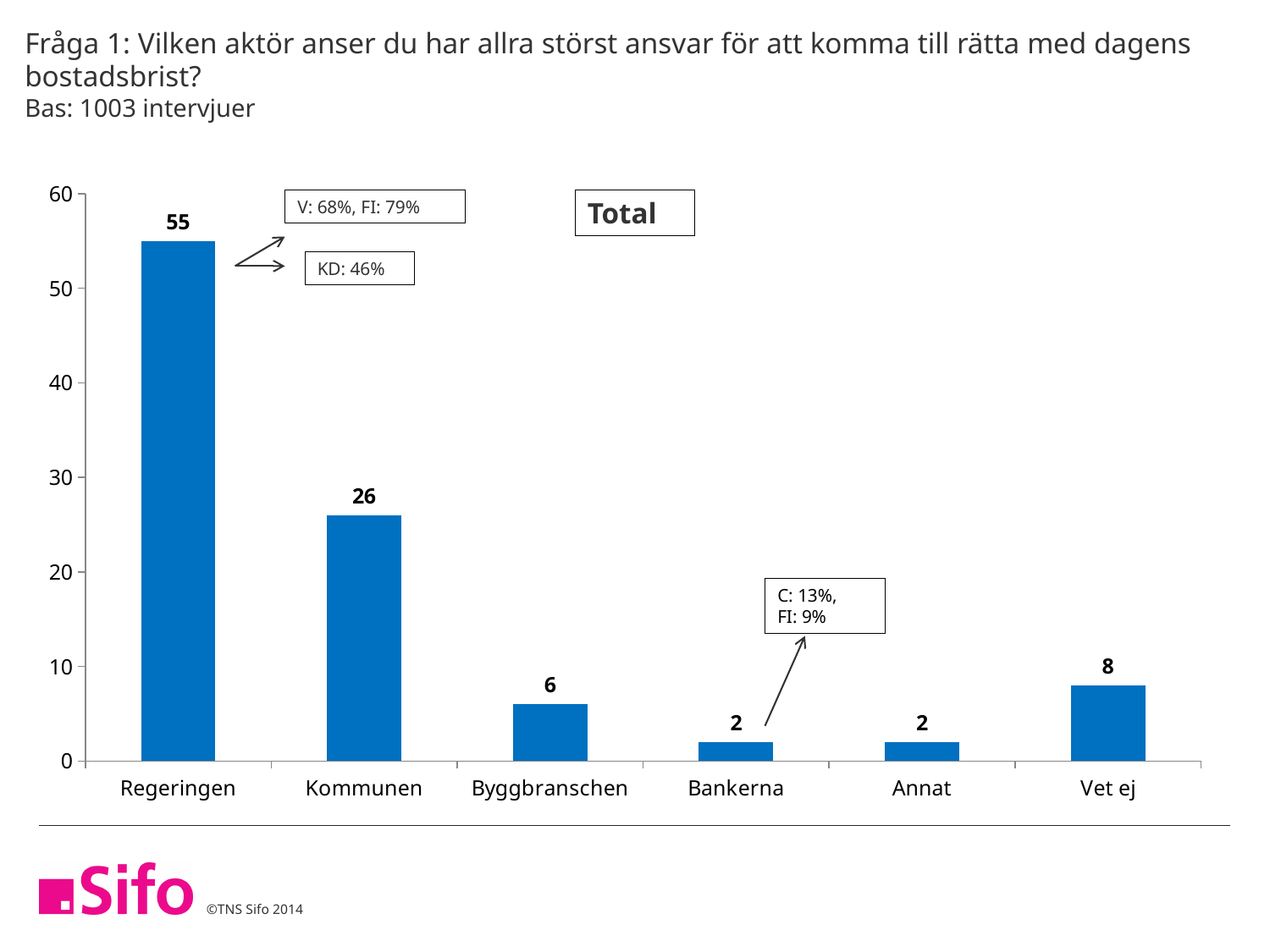
What is the value for Vet ej? 8 What is the value for Regeringen? 55 Which is larger, the value for Byggbranschen or the value for Vet ej? Vet ej What is the difference between the values for Regeringen and Kommunen? 29 What kind of chart is shown on the slide? bar chart Which category has the highest value? Regeringen How many categories are shown on the x axis? 6 Is the value for Kommunen greater or less than 30? less What is the value for Bankerna? 2 What label appears in the box at the top of the chart? Total What is the value for Kommunen? 26 What is the value for Byggbranschen? 6